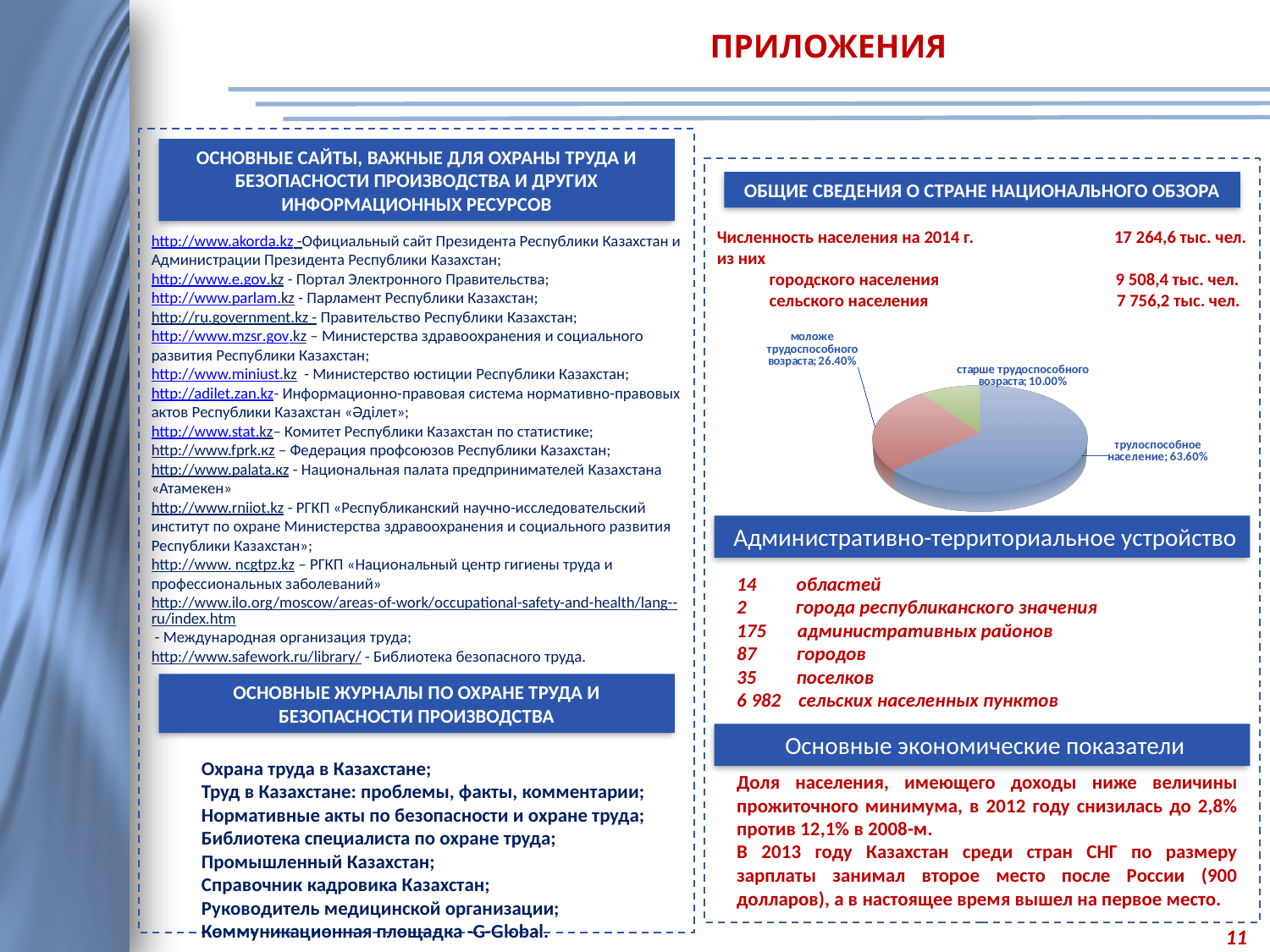
What is the combined share of the "моложе трудоспособного возраста" and "старше трудоспособного возраста" slices? 36.40% What is the difference between the shares for "моложе трудоспособного возраста" and "старше трудоспособного возраста"? 16.40% What share of the pie is labelled "трулоспособное население"? 63.60% How many slices does the pie chart have? 3 What share of the pie is labelled "старше трудоспособного возраста"? 10.00% What share of the pie is labelled "моложе трудоспособного возраста"? 26.40% What is the difference between the shares for "трулоспособное население" and "моложе трудоспособного возраста"? 37.20% Which slice of the pie chart is the smallest? старше трудоспособного возраста Which slice of the pie chart is the largest? трулоспособное население Which is larger in the pie chart: "моложе трудоспособного возраста" or "старше трудоспособного возраста"? моложе трудоспособного возраста What colour is the largest slice of the pie chart? Blue What kind of chart is shown on the slide? Pie chart